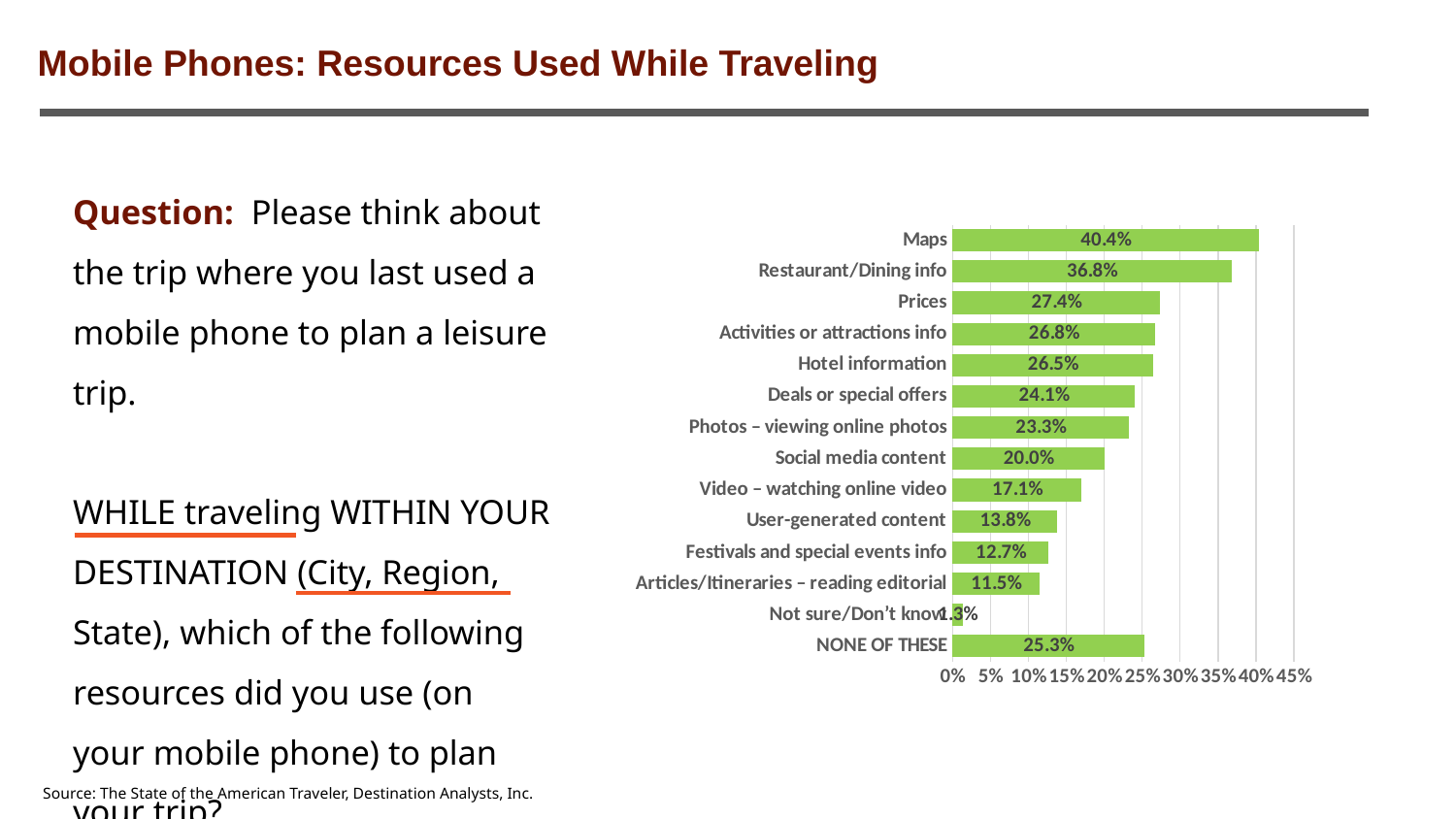
What is the value shown for Restaurant/Dining info? 36.8% What type of chart is used on this slide? Bar chart What percentage of respondents used Maps on their mobile phone while traveling within their destination? 40.4% Is the value for Video – watching online video greater or less than 20%? less Which category has the lowest percentage in the chart? Not sure/Don't know What is the value for NONE OF THESE? 25.3% How many categories are shown in the bar chart? 14 What is the difference between the values for Prices and Hotel information? 0.9% What is the difference between the percentages for Maps and Restaurant/Dining info? 3.6% What percentage is shown for Social media content? 20.0% Which is larger: the value for Deals or special offers or the value for Photos – viewing online photos? Deals or special offers Which resource has the highest percentage in the chart? Maps